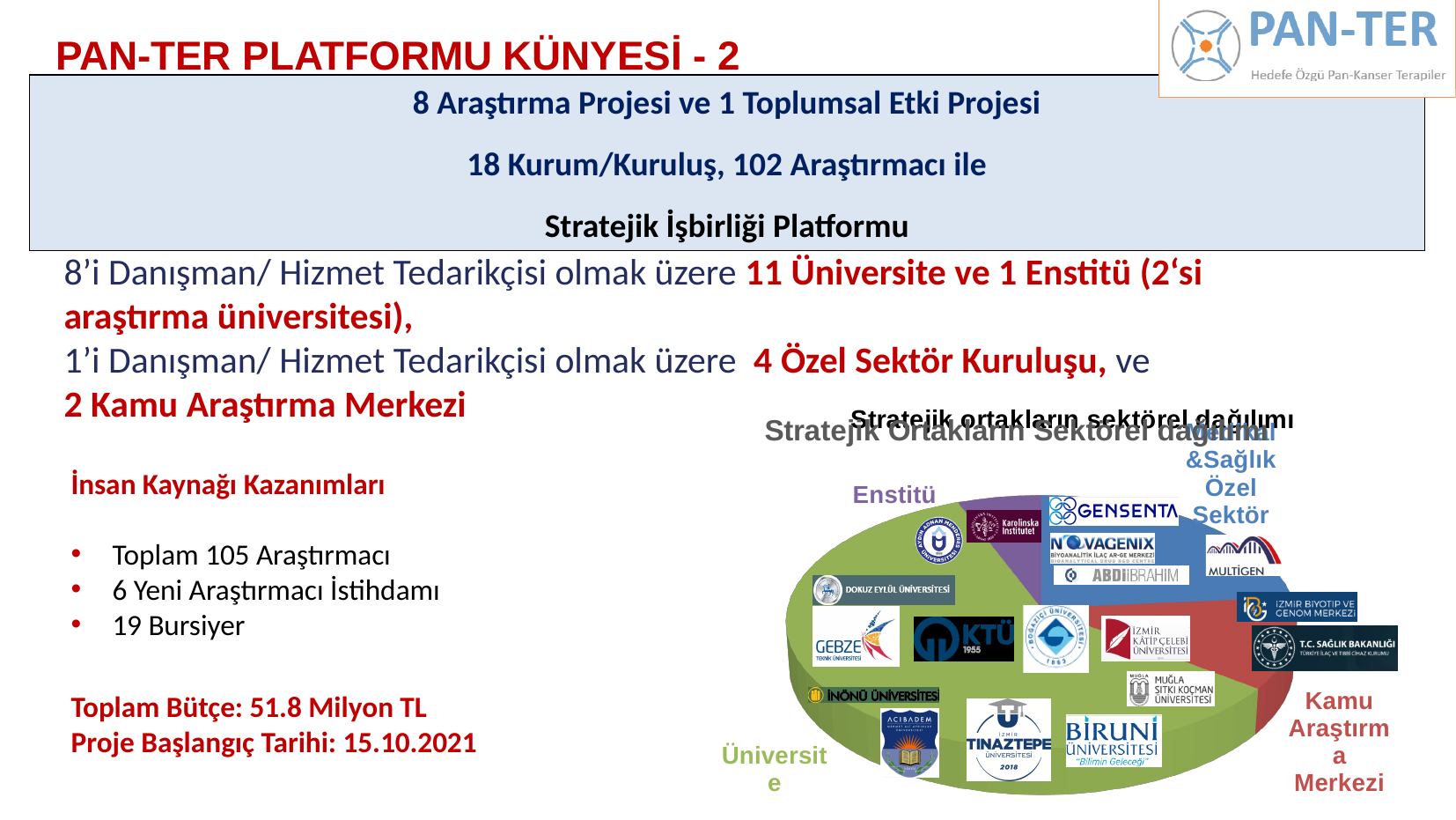
Which category has the largest slice in the pie chart? Üniversite What is the title of the pie chart? Stratejik Ortakların Sektörel dağılımı Which slice is larger in the pie chart, Enstitü or Kamu Araştırma Merkezi? Kamu Araştırma Merkezi What kind of chart is shown on the slide? pie chart Which slice is larger in the pie chart, Üniversite or Kamu Araştırma Merkezi? Üniversite What colour is the Üniversite slice in the pie chart? green Which category has the smallest slice in the pie chart? Enstitü How many categories are labelled around the pie chart? 4